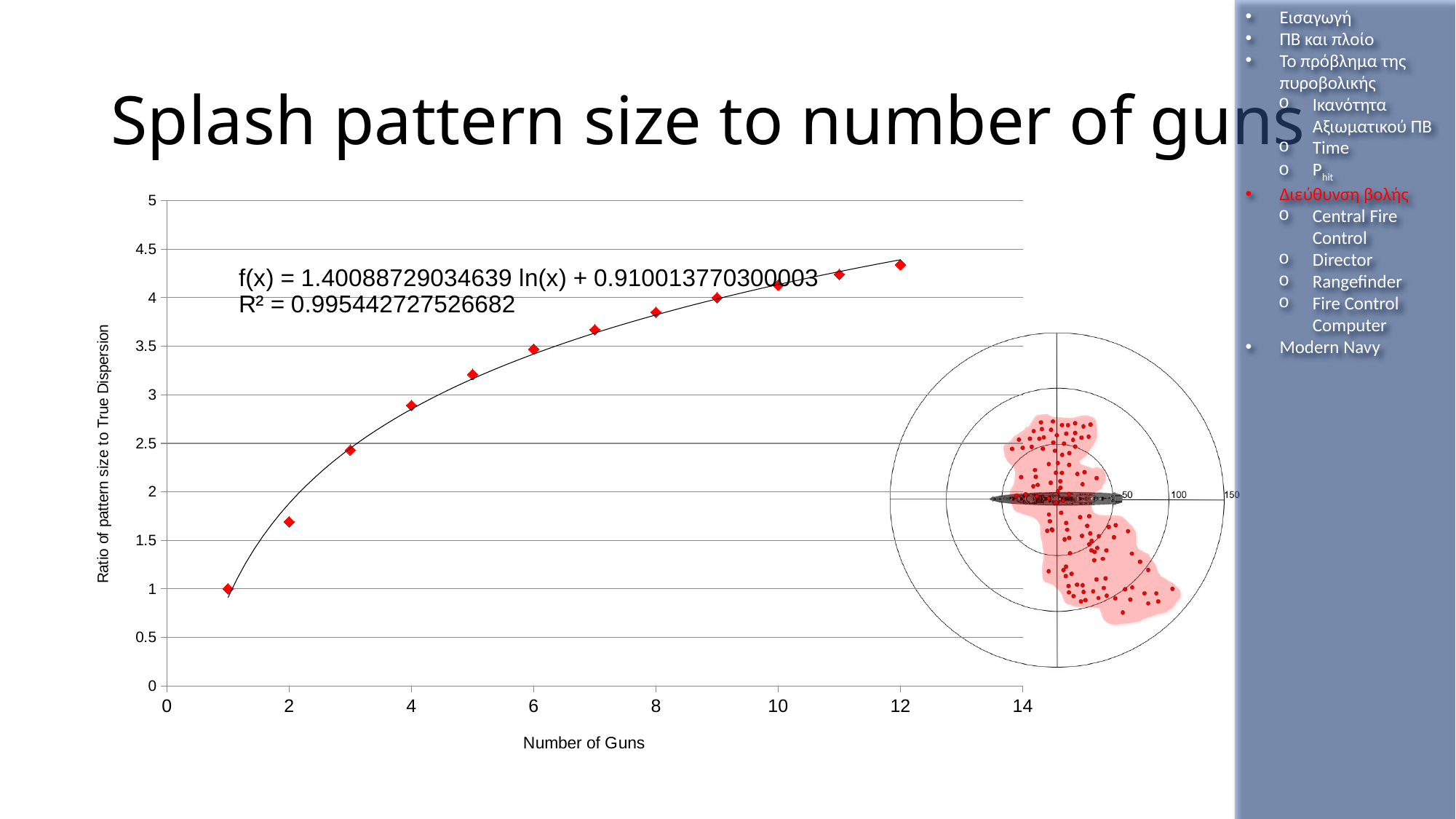
Is the value for 2 guns greater or less than 1.5? greater Which number of guns has the lowest ratio of pattern size to true dispersion? 1 What is the title of the x axis? Number of Guns What kind of chart is shown on the slide? scatter chart What R² value is printed on the chart? 0.995442727526682 Is the value for 12 guns greater or less than 4.5? less How many data points are plotted on the chart? 12 Which number of guns has the highest ratio of pattern size to true dispersion? 12 What is the ratio of pattern size to true dispersion for 1 gun? 1 Does the ratio of pattern size to true dispersion rise or fall as the number of guns increases? rises Which has a larger ratio of pattern size to true dispersion, 4 guns or 8 guns? 8 guns Is the value for 8 guns greater or less than 3.5? greater